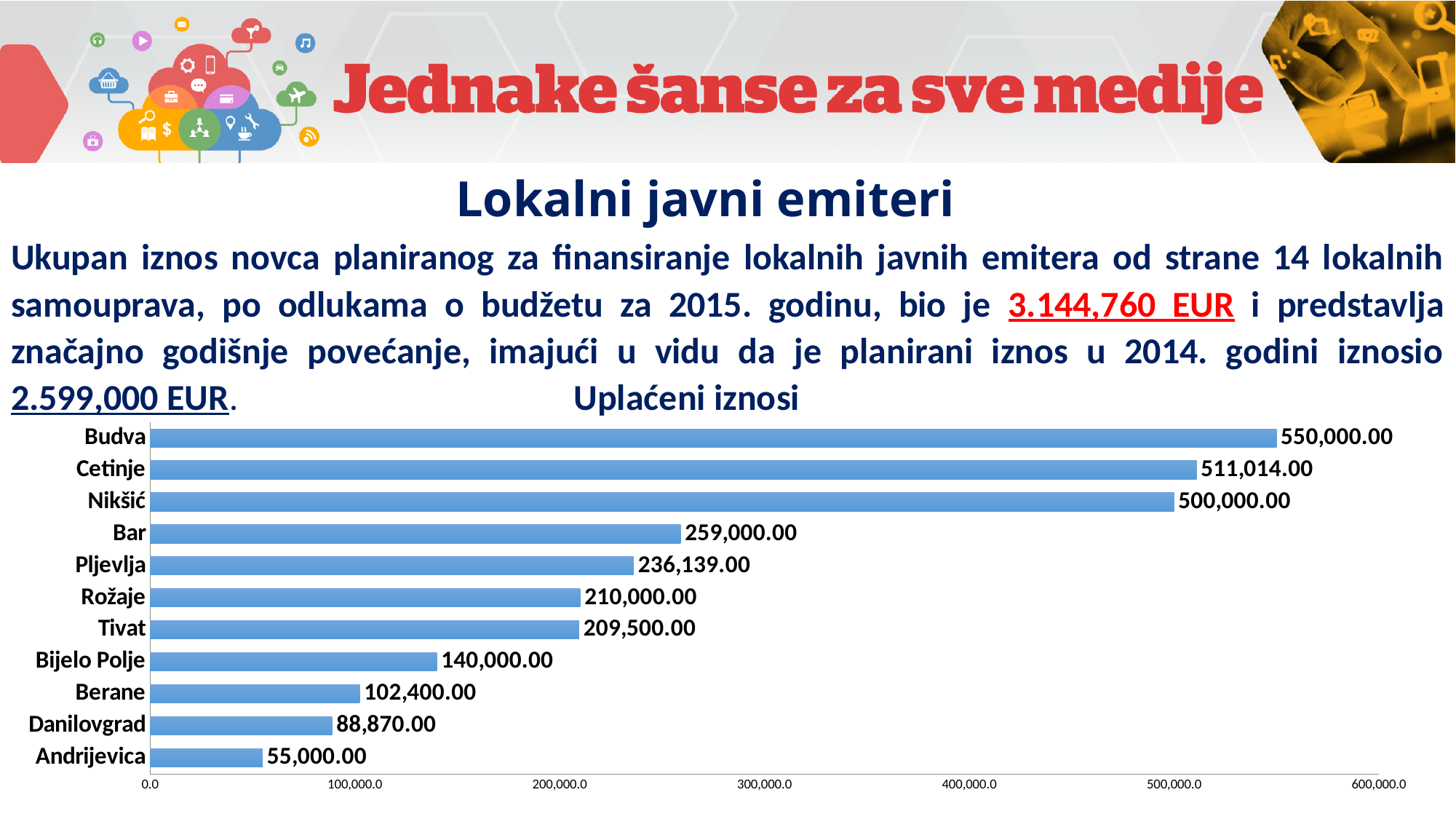
Is the value for Bijelo Polje greater or less than 100,000.0? greater How many categories are shown in the chart? 11 What is the difference between the values for Bar and Pljevlja? 22,861.00 What kind of chart is shown on the slide? bar chart Which category has the highest value? Budva Which category has the lowest value? Andrijevica What is the value for Danilovgrad? 88,870.00 What is the title of the chart? Uplaćeni iznosi What is the value for Pljevlja? 236,139.00 Which is larger, the value for Cetinje or the value for Nikšić? Cetinje What is the value for Budva? 550,000.00 What is the difference between the values for Budva and Cetinje? 38,986.00